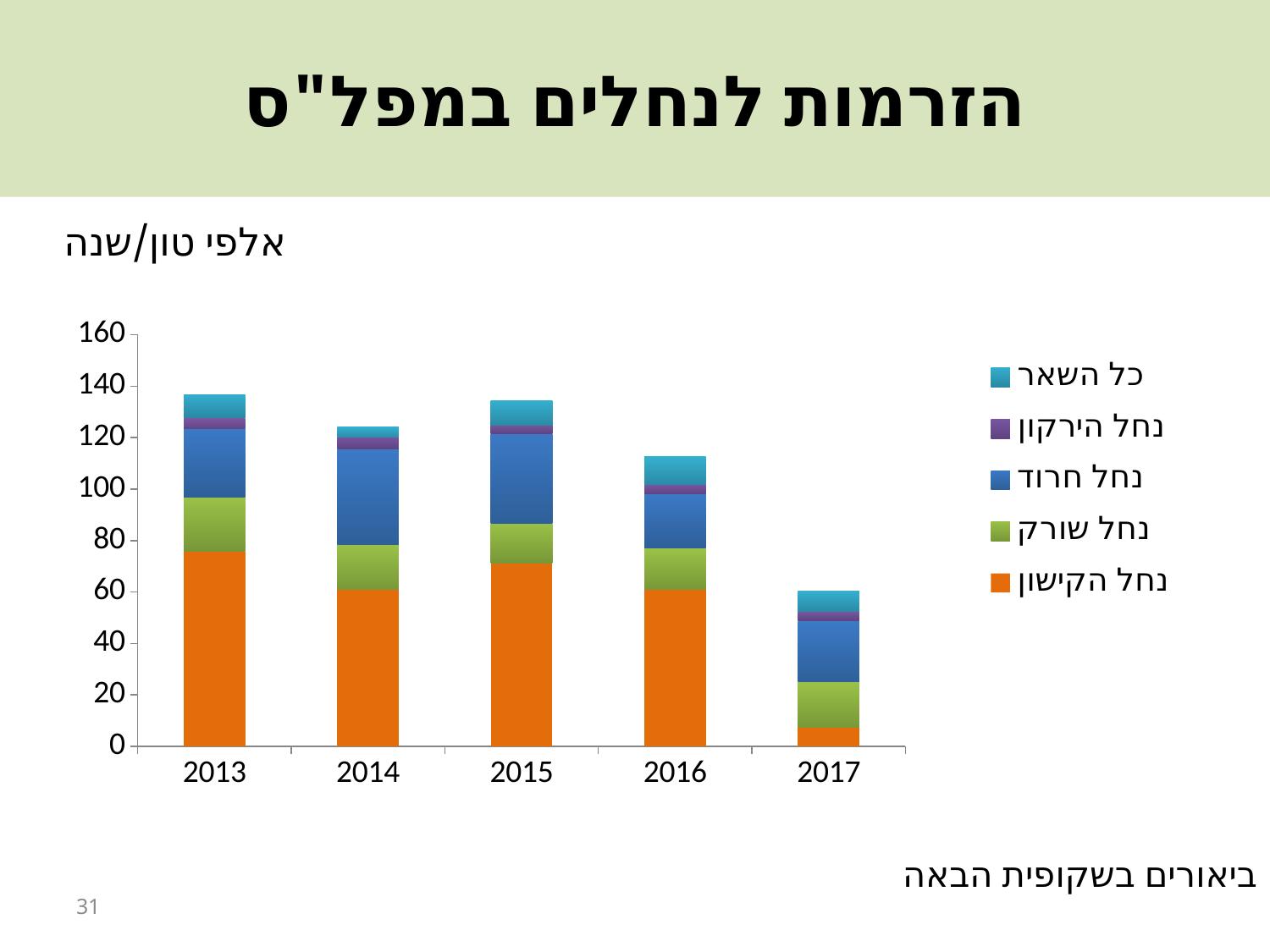
Which year has the lowest total stacked bar? 2017 Is the total stacked value for 2016 greater or less than 100? greater Is the value of נחל הקישון (the bottom orange segment) in 2013 greater or less than 60? greater Which year has the larger total stacked bar, 2013 or 2017? 2013 What is the title of the slide containing the chart? הזרמות לנחלים במפל"ס Is the total stacked value for 2013 greater or less than 120? greater How many years (categories) are shown on the x axis of the chart? 5 What kind of chart is shown on the slide? stacked bar chart How many series does the chart's legend list? 5 Which series is shown at the bottom of each stacked bar (orange)? נחל הקישון